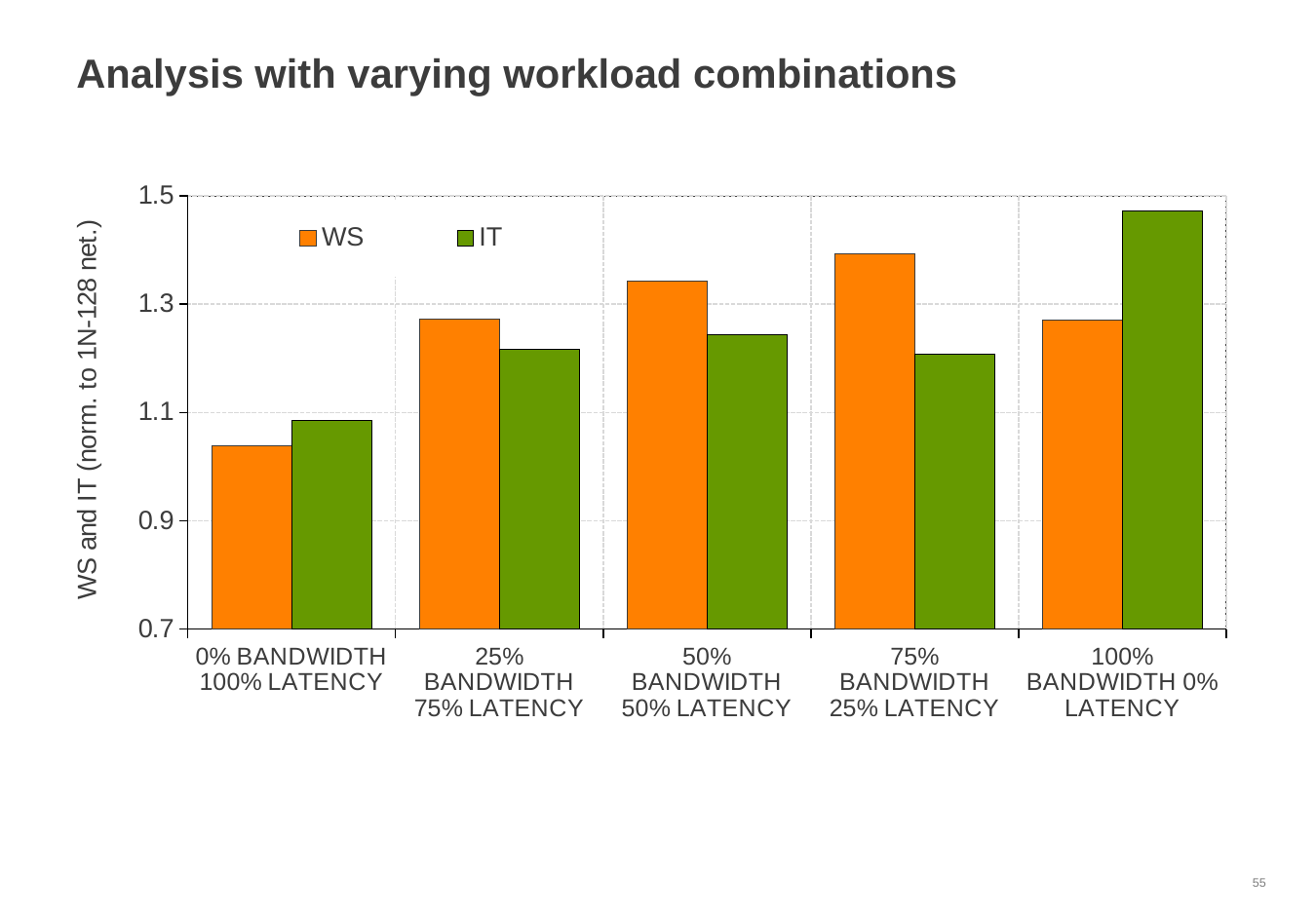
What kind of chart is shown on the slide? bar chart How many workload combinations are shown on the x axis? 5 Which workload combination has the highest WS value? 75% BANDWIDTH 25% LATENCY What is the title of the slide? Analysis with varying workload combinations Which workload combination has the lowest IT value? 0% BANDWIDTH 100% LATENCY Which workload combination has the highest IT value? 100% BANDWIDTH 0% LATENCY Is the WS value for 0% BANDWIDTH 100% LATENCY greater or less than 1.1? less For 75% BANDWIDTH 25% LATENCY, which is larger, WS or IT? WS For 100% BANDWIDTH 0% LATENCY, which is larger, WS or IT? IT Is the IT value for 100% BANDWIDTH 0% LATENCY greater or less than 1.3? greater How many series does the legend list? 2 Which workload combination has the lowest WS value? 0% BANDWIDTH 100% LATENCY